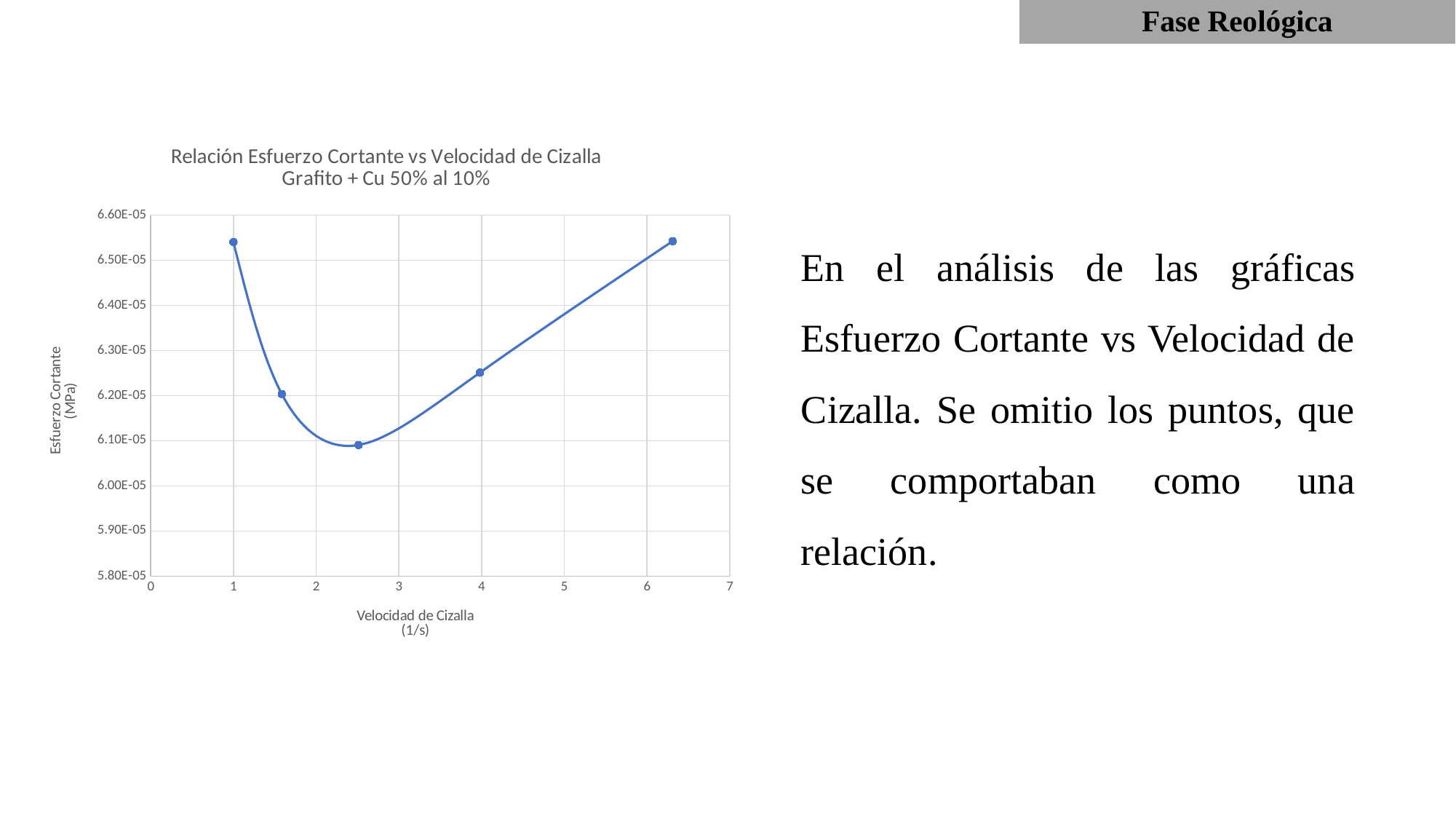
What is the label of the x axis of the chart? Velocidad de Cizalla (1/s) What is the title of the chart? Relación Esfuerzo Cortante vs Velocidad de Cizalla Grafito + Cu 50% al 10% What kind of chart is shown on the slide? Line chart How many data points are plotted on the chart? 5 Is the Esfuerzo Cortante value at the rightmost plotted point (around Velocidad de Cizalla 6.3) greater or less than 6.50E-05? greater Is the Esfuerzo Cortante value at Velocidad de Cizalla = 1 greater or less than 6.50E-05? greater Which has the larger Esfuerzo Cortante: the point at Velocidad de Cizalla = 1 or the point at Velocidad de Cizalla = 4? The point at Velocidad de Cizalla = 1 Is the Esfuerzo Cortante value at Velocidad de Cizalla = 4 greater or less than 6.20E-05? greater How does the Esfuerzo Cortante change as Velocidad de Cizalla increases from about 2.5 to about 6.3? It rises How does the Esfuerzo Cortante change as Velocidad de Cizalla increases from 1 to about 2.5? It falls